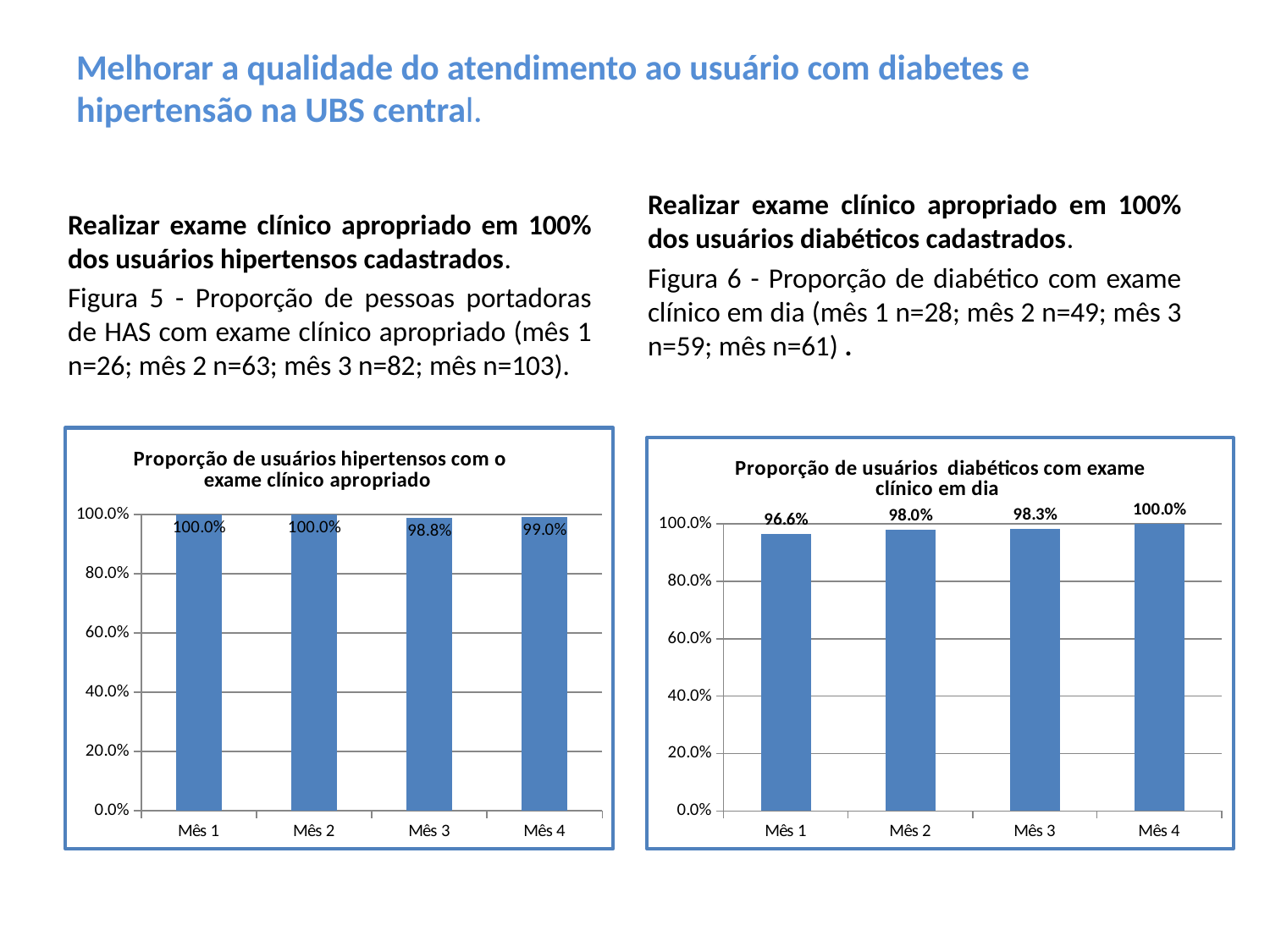
In the right chart (Proporção de usuários diabéticos com exame clínico em dia), what is the value for Mês 1? 96.6% In the left chart (Proporção de usuários hipertensos com o exame clínico apropriado), what is the difference between the values for Mês 1 and Mês 3? 1.2% In the right chart (Proporção de usuários diabéticos com exame clínico em dia), do the values rise or fall from Mês 1 to Mês 4? rise In the right chart (Proporção de usuários diabéticos com exame clínico em dia), which month has the highest value? Mês 4 In the left chart (Proporção de usuários hipertensos com o exame clínico apropriado), what is the value for Mês 4? 99.0% In the right chart (Proporção de usuários diabéticos com exame clínico em dia), which month has the lowest value? Mês 1 In the left chart (Proporção de usuários hipertensos com o exame clínico apropriado), what is the value for Mês 3? 98.8% In the left chart (Proporção de usuários hipertensos com o exame clínico apropriado), which month has the lowest value? Mês 3 In the right chart (Proporção de usuários diabéticos com exame clínico em dia), what is the difference between the values for Mês 4 and Mês 1? 3.4% In the right chart (Proporção de usuários diabéticos com exame clínico em dia), what is the value for Mês 3? 98.3% What kind of chart is the right chart (Proporção de usuários diabéticos com exame clínico em dia)? bar chart How many months are shown on the x axis of the left chart (Proporção de usuários hipertensos com o exame clínico apropriado)? 4